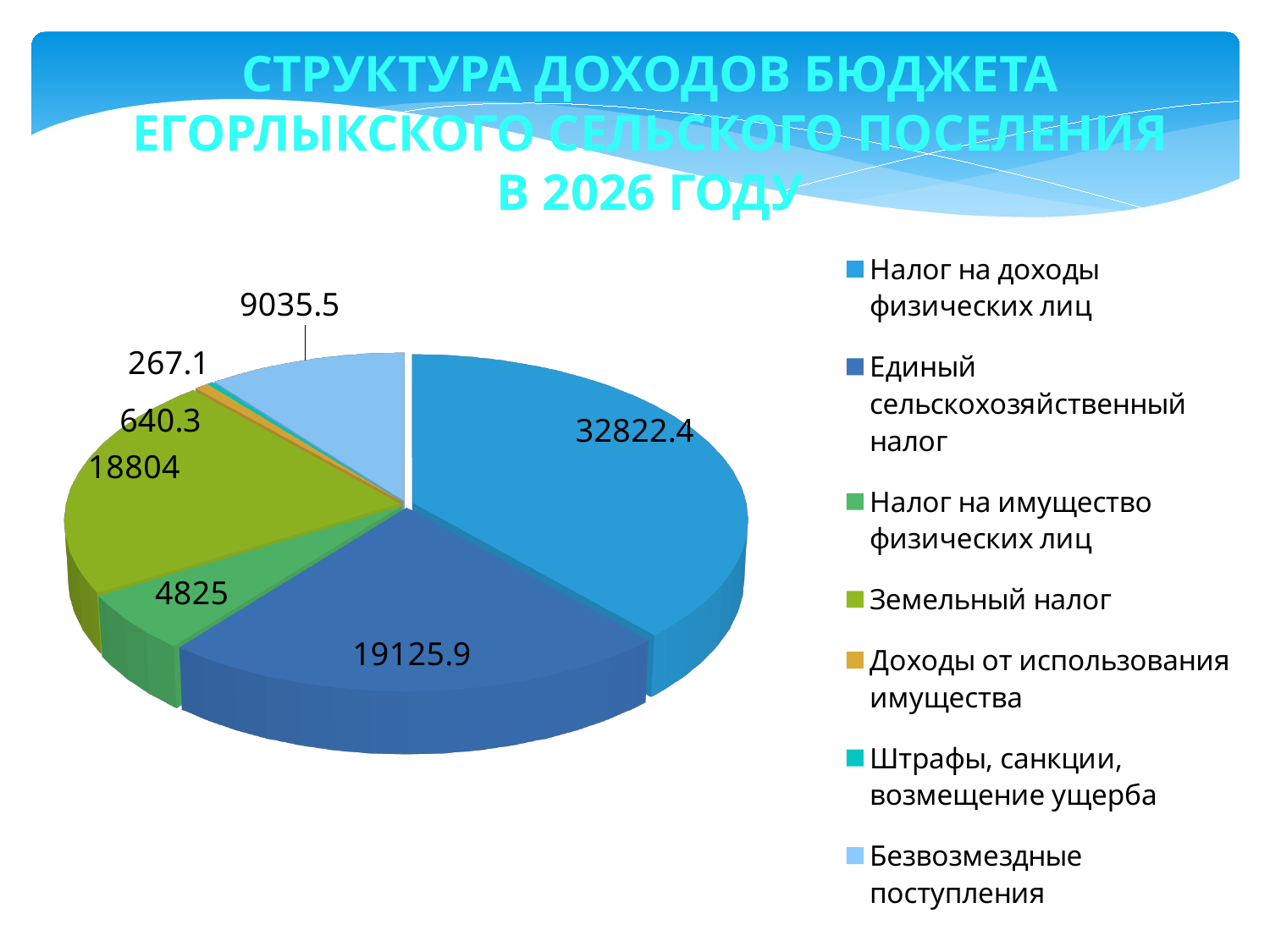
How many categories does the legend list? 7 What is the difference between the values for Налог на доходы физических лиц and Единый сельскохозяйственный налог? 13696.5 What is the value for Безвозмездные поступления? 9035.5 Which is larger: the value for Земельный налог or the value for Безвозмездные поступления? Земельный налог What type of chart is shown on the slide? pie chart What is the value for Единый сельскохозяйственный налог? 19125.9 What is the value for Налог на имущество физических лиц? 4825 Which category has the largest slice of the pie? Налог на доходы физических лиц What is the value for Налог на доходы физических лиц? 32822.4 What colour is the slice for Земельный налог? yellow-green What is the value for Земельный налог? 18804 Which category has the smallest slice of the pie? Штрафы, санкции, возмещение ущерба